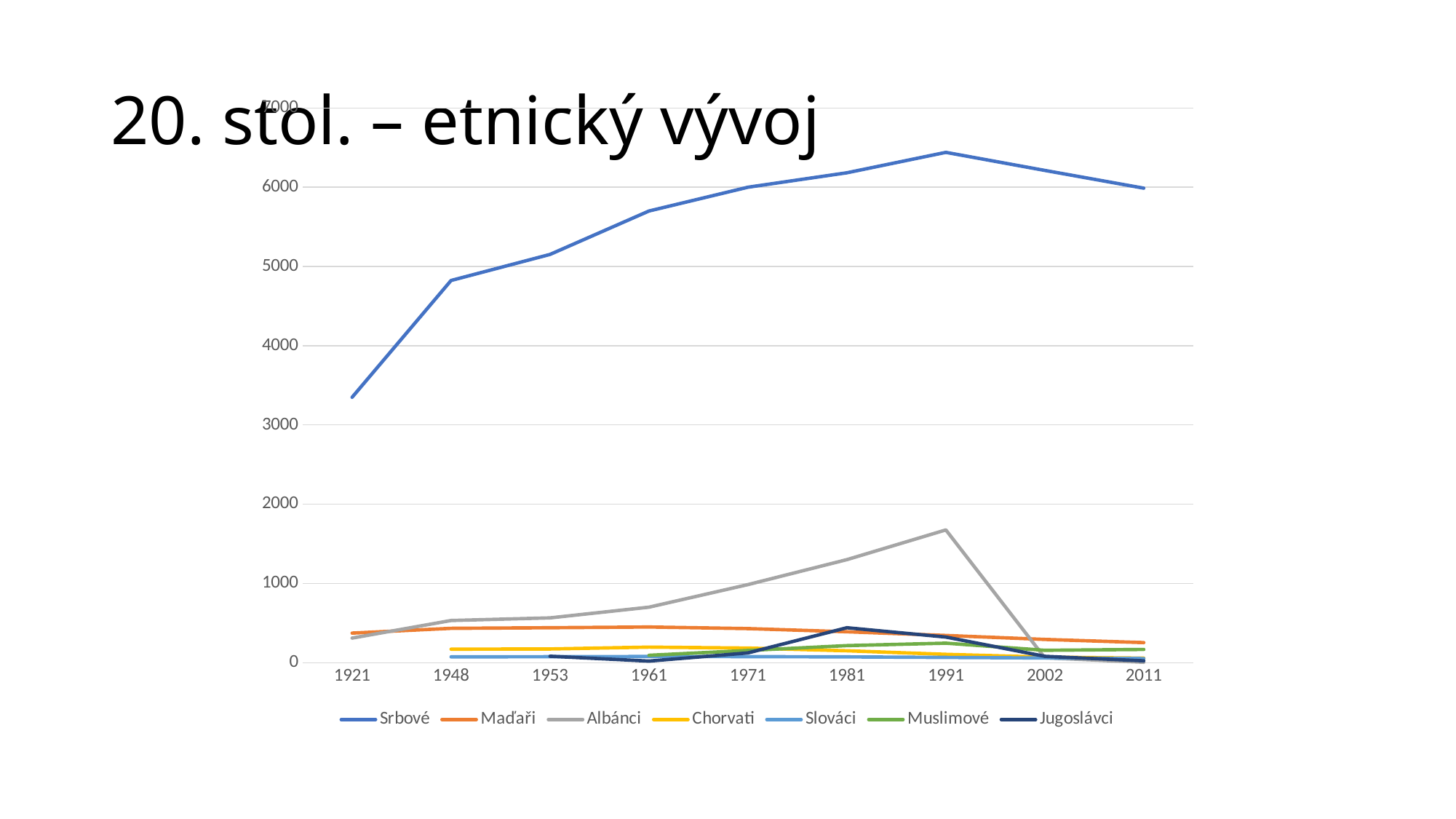
In which year does the Srbové line reach its highest point? 1991 What kind of chart is shown on the slide? line chart Is the value for Srbové in 1921 greater or less than 3000? greater How many years are marked on the x axis? 9 In which year does the Albánci line reach its highest point? 1991 What colour is the Albánci line? grey Does the Srbové line rise or fall between 1921 and 1991? rise Which is larger in 1991, the value for Albánci or the value for Maďaři? Albánci How many series does the legend list? 7 Which series has the highest value in 1991? Srbové Is the value for Maďaři in 1961 greater or less than 1000? less Is the value for Albánci in 1991 greater or less than 1000? greater